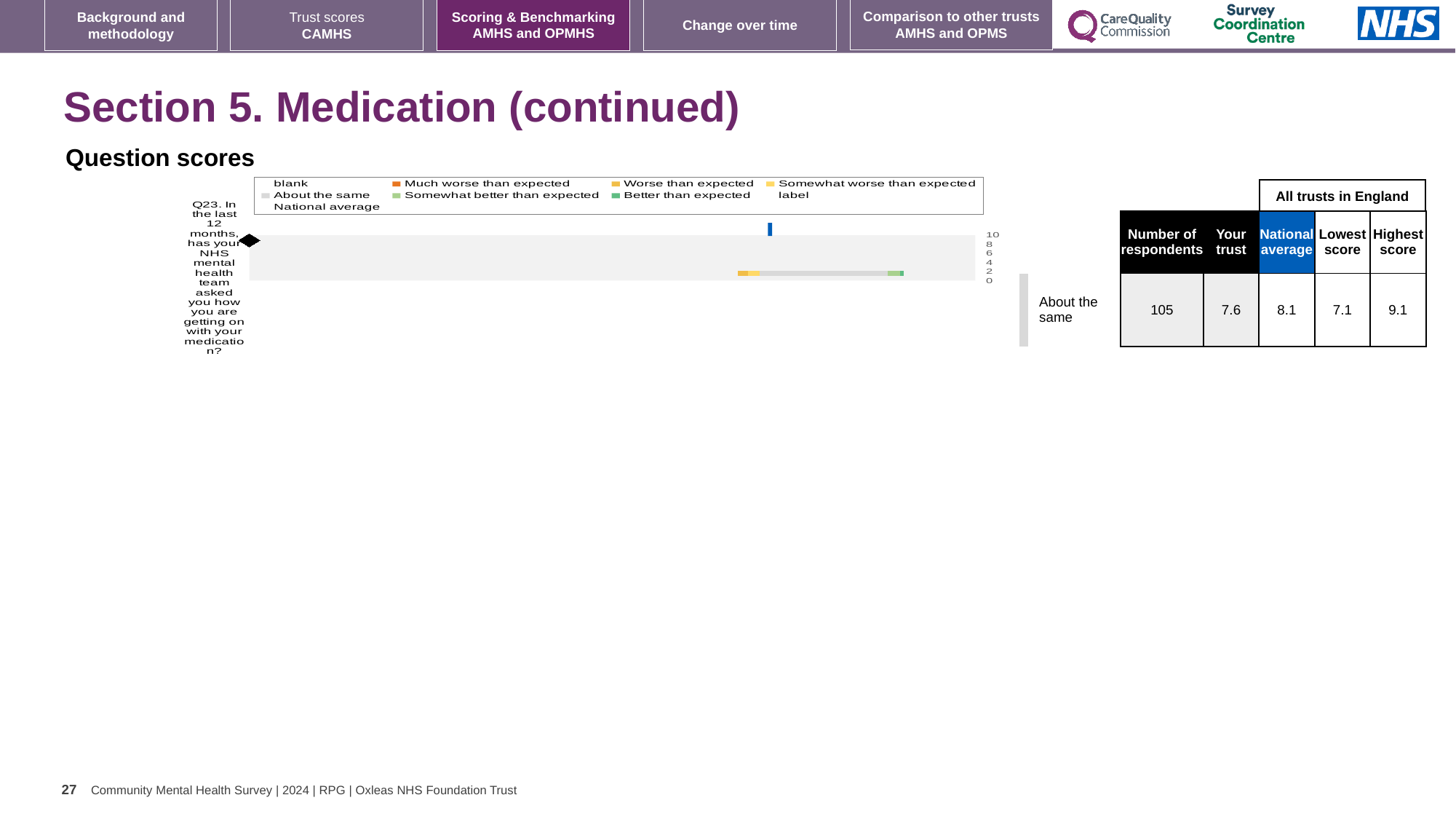
What benchmark category is Q23 assigned to on the slide? About the same What is the difference between the national average (8.1) and the 'Your trust' score (7.6) for Q23? 0.5 What kind of chart is shown on the slide? bar chart What is the lowest score among all trusts in England for Q23? 7.1 What is the highest tick value shown on the chart's score axis? 10 Which question number is plotted in the chart? Q23 How many survey questions are plotted in the chart? 1 What is the highest score among all trusts in England for Q23? 9.1 What is the national average score for Q23? 8.1 Which is larger for Q23, the 'Your trust' score or the national average? National average What is the number of respondents for Q23? 105 What is the 'Your trust' score for Q23? 7.6